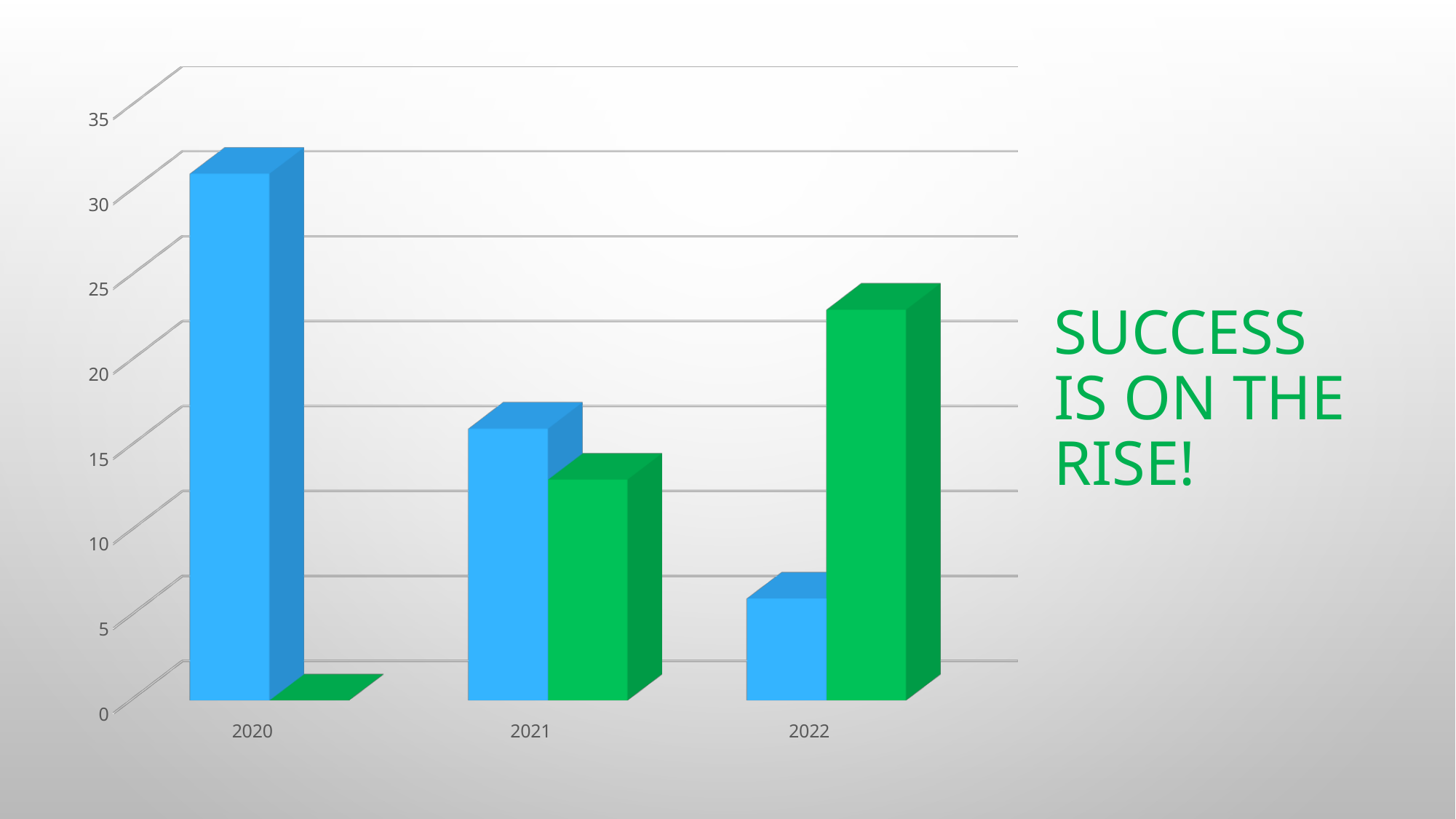
What kind of chart is shown on the slide? bar chart In which year is the blue series highest? 2020 Is the value of the green bar for 2021 greater or less than 15? less Is the value of the blue bar for 2022 greater or less than 10? less How many categories are shown on the x axis of the chart? 3 In which year is the green series lowest? 2020 Is the value of the blue bar for 2020 greater or less than 25? greater For 2022, which bar is larger, the blue one or the green one? green Do the values of the blue series rise or fall from 2020 to 2022? fall How many data series are plotted in the chart? 2 What are the years shown on the x axis of the chart? 2020, 2021, 2022